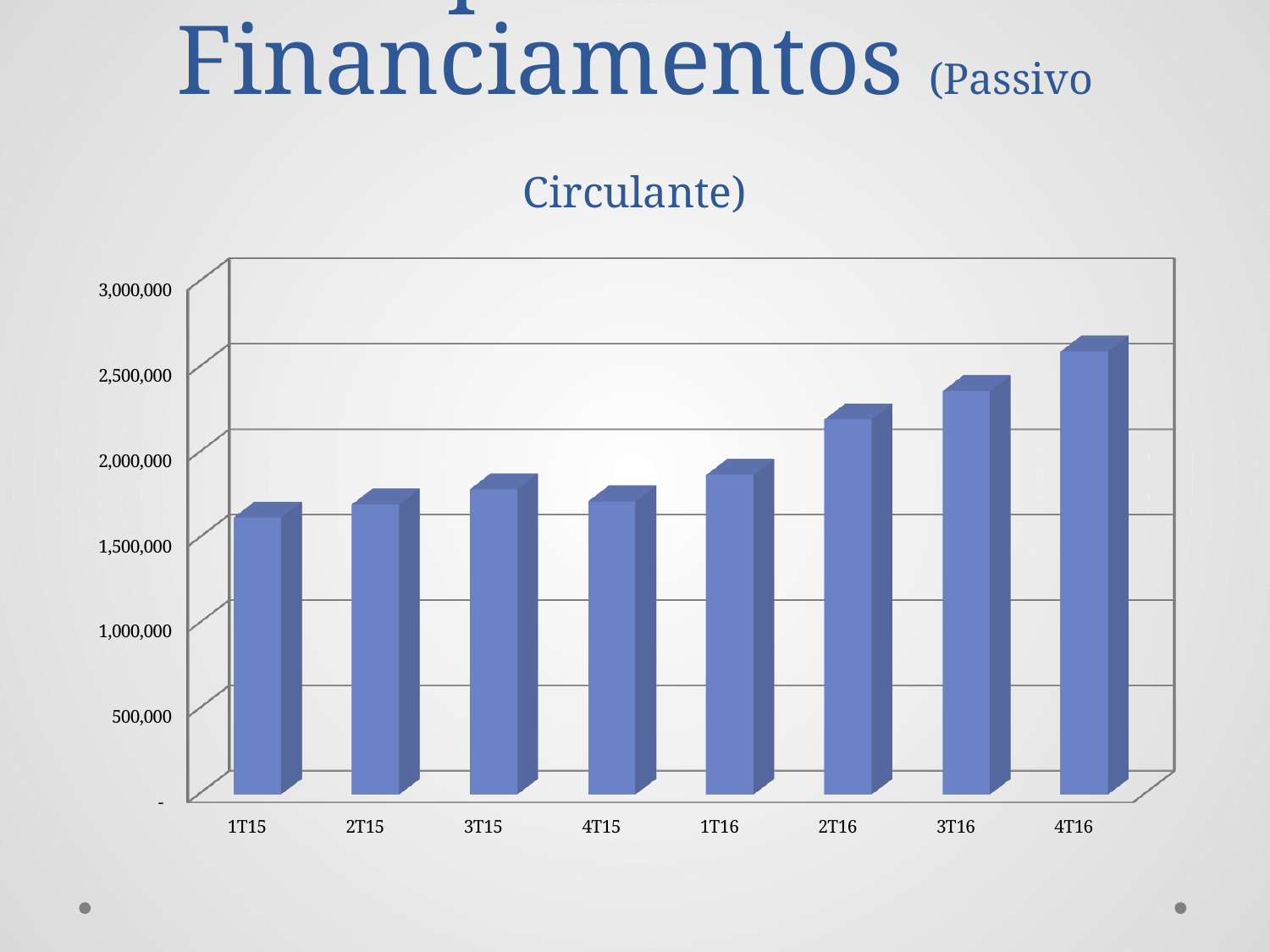
What kind of chart is shown on the slide? bar chart Which is larger, the value for 3T16 or the value for 2T16? 3T16 What is the first quarter label shown on the x axis? 1T15 Is the value for 3T15 greater or less than 1,500,000? greater Which quarter has the lowest value on the chart? 1T15 Do the values generally rise or fall from 1T15 to 4T16? rise Which is larger, the value for 4T16 or the value for 1T15? 4T16 Is the value for 3T16 greater or less than 2,000,000? greater Which quarter has the highest value on the chart? 4T16 Is the value for 1T15 greater or less than 2,000,000? less How many quarters (categories) are plotted on the chart? 8